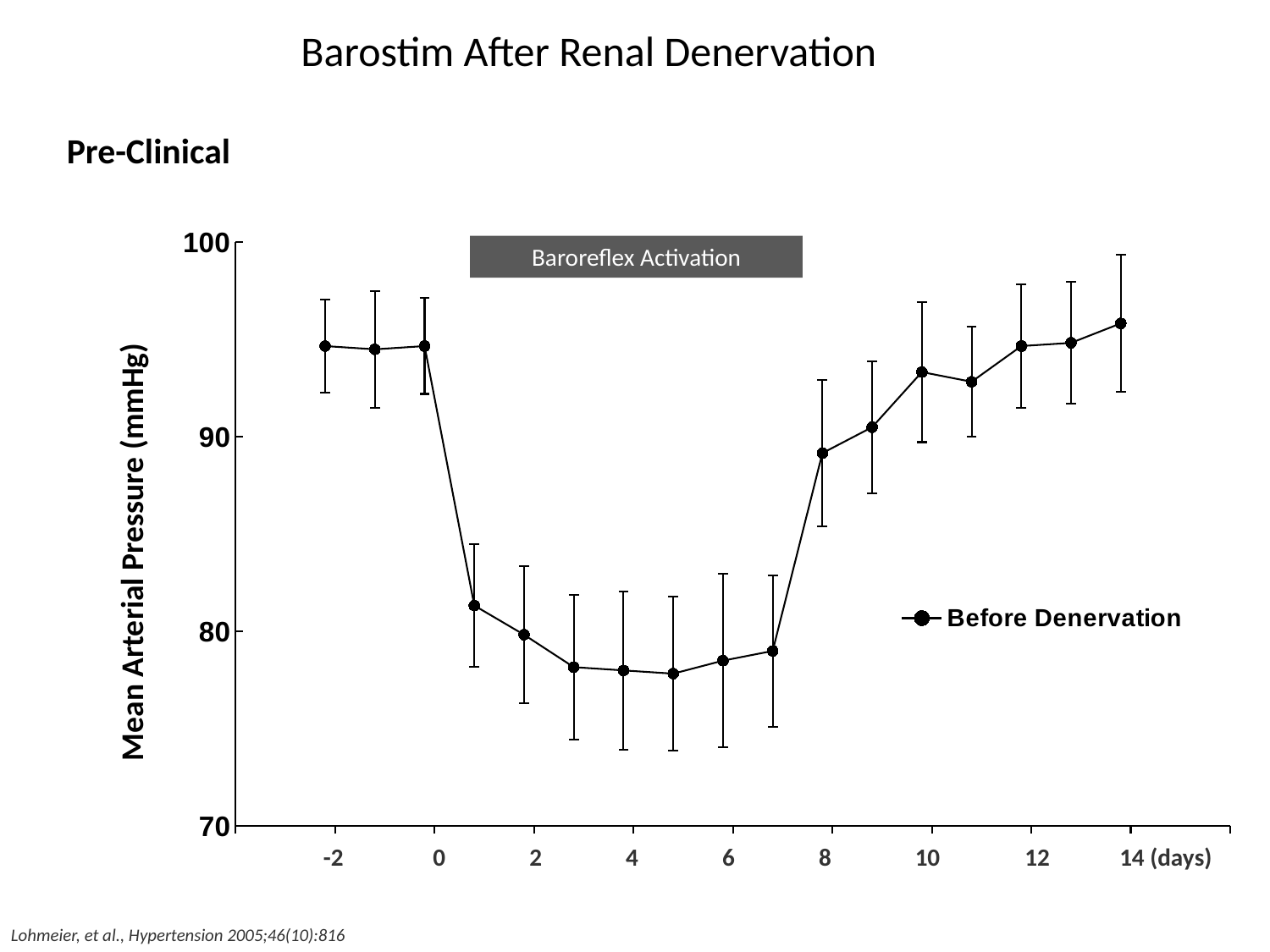
What kind of chart is shown on the slide? line chart Is the value for the first point (around day -2) greater or less than 90? greater Which is larger, the value at around day 2 or the value at around day 10? day 10 How many series does the legend list? 1 Is the value for the point around day 10 greater or less than 90? greater Do the values rise or fall from day 8 to day 14? rise Is the value for the last point (around day 14) greater or less than 90? greater What is the name of the series shown in the legend? Before Denervation Which is larger, the value at around day -2 or the value at around day 4? day -2 What is the label of the y axis? Mean Arterial Pressure (mmHg) How many data points are plotted on the line? 17